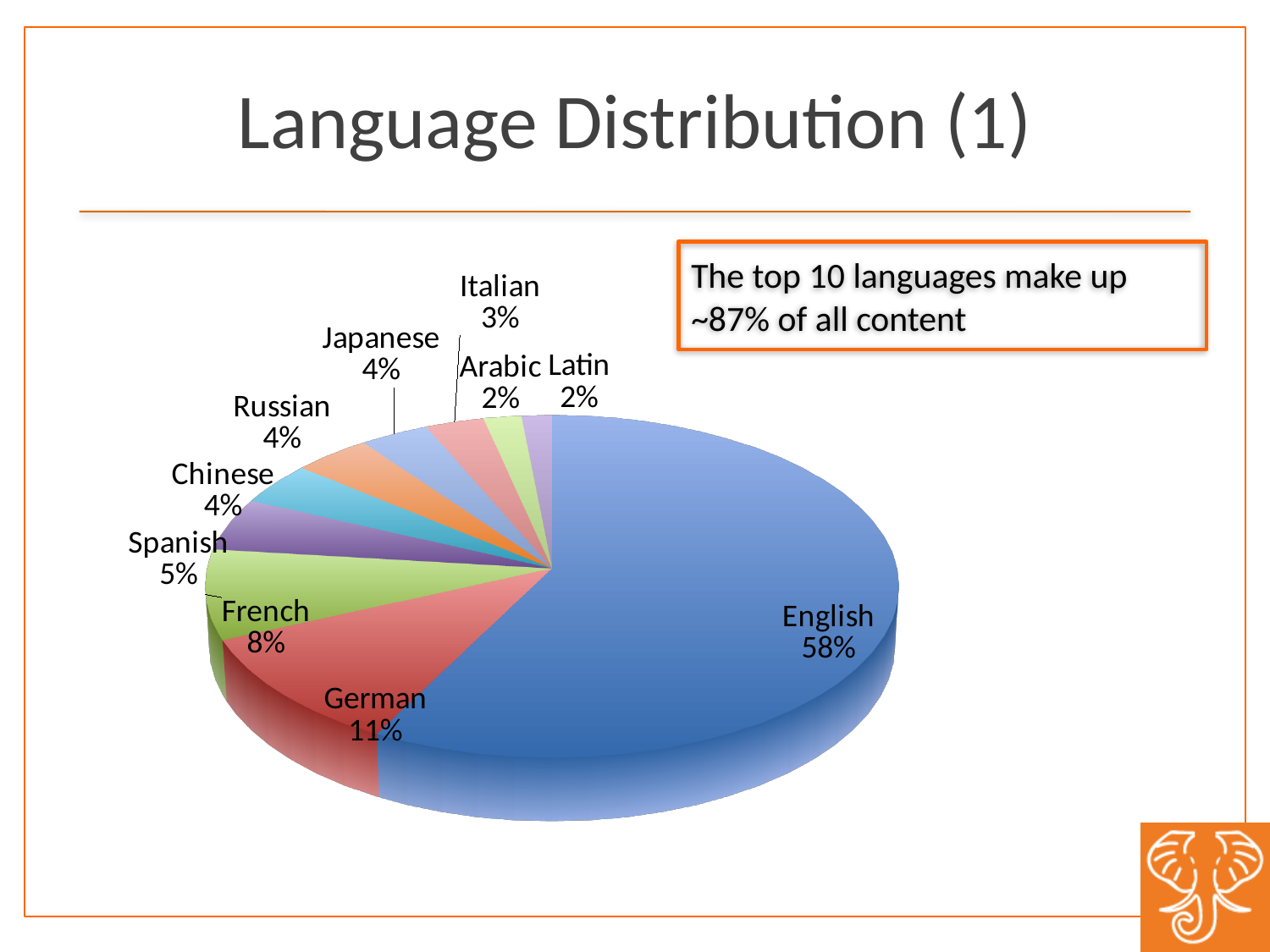
What is the difference in percentage points between English and German? 47 What percentage is shown for Italian? 3% What kind of chart is shown on the slide? Pie chart Which is larger, the share for French or the share for Spanish? French What is the title of the slide? Language Distribution (1) What percentage is shown for German? 11% What percentage is shown for Spanish? 5% How many language slices are labelled on the pie chart? 10 What percentage is shown for French? 8% What share of the pie does English account for? 58% Which language has the largest slice of the pie? English According to the text box, what share of all content do the top 10 languages make up? ~87%